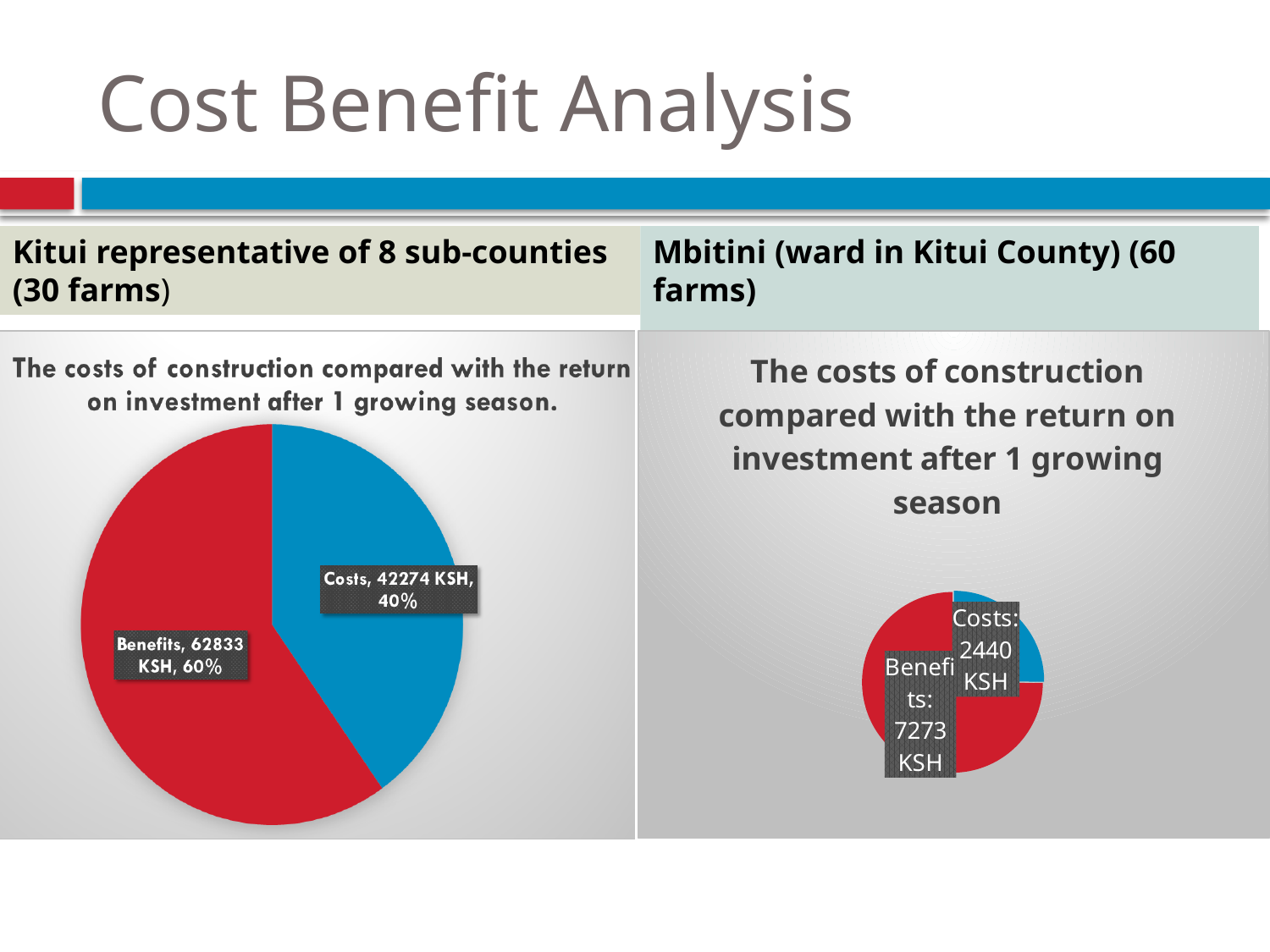
In the left pie chart (Kitui, 30 farms), what share of the pie do Benefits represent? 60% How many slices does the right pie chart (Mbitini, 60 farms) have? 2 What type of chart is used on the left side of the slide (Kitui, 30 farms)? Pie chart In the left pie chart (Kitui, 30 farms), what is the difference between Benefits and Costs? 20559 KSH In the right pie chart (Mbitini, 60 farms), what is the difference between Benefits and Costs? 4833 KSH In the right pie chart (Mbitini, 60 farms), what is the value for Costs? 2440 KSH In the left pie chart (Kitui, 30 farms), what share of the pie do Costs represent? 40% In the left pie chart (Kitui, 30 farms), what is the value for Costs? 42274 KSH In the right pie chart (Mbitini, 60 farms), which slice is larger, Costs or Benefits? Benefits In the left pie chart (Kitui, 30 farms), which slice is the largest? Benefits In the right pie chart (Mbitini, 60 farms), what is the value for Benefits? 7273 KSH In the left pie chart (Kitui, 30 farms), what is the value for Benefits? 62833 KSH